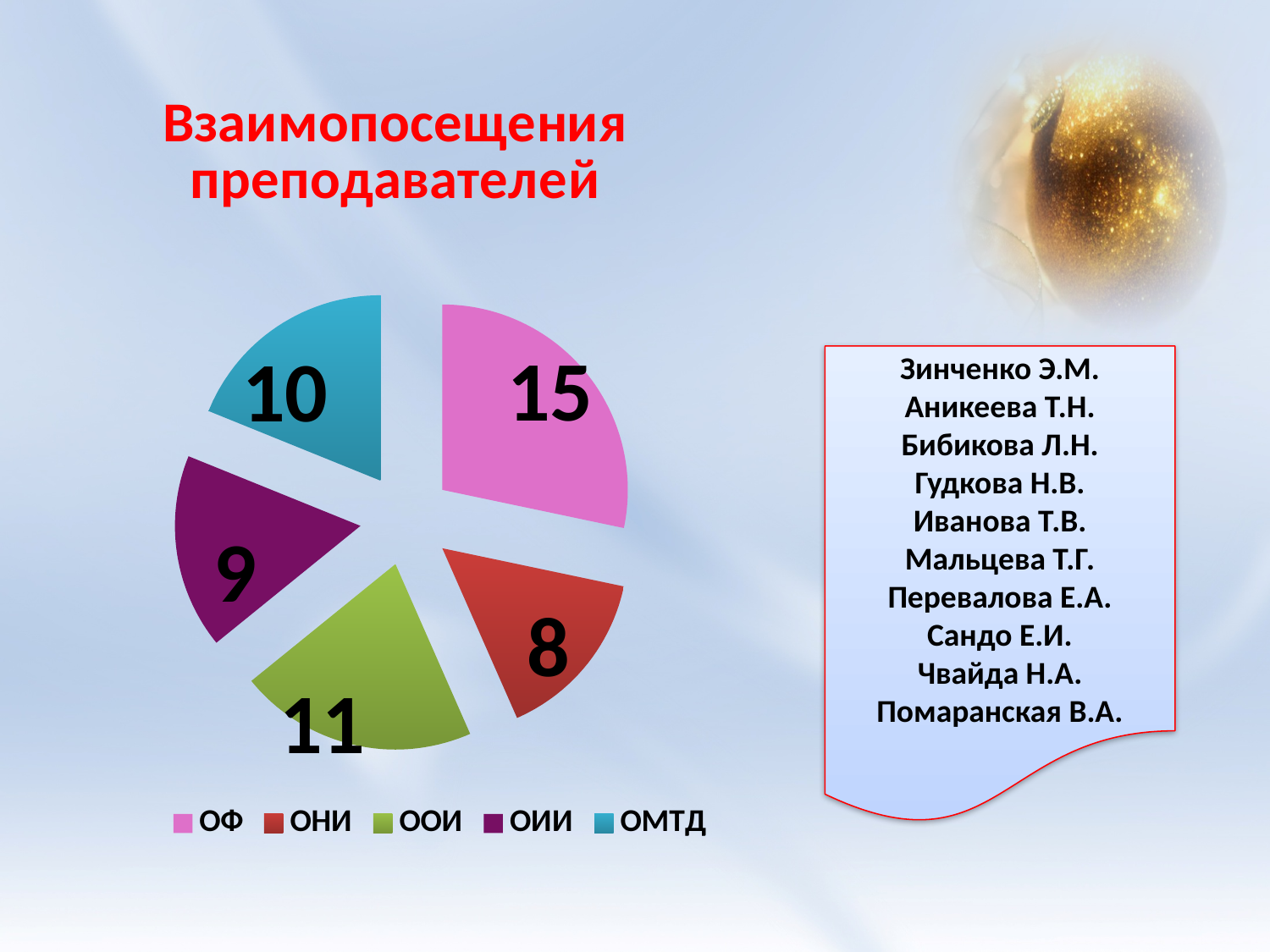
What is the value for ООИ in the pie chart? 11 What is the total of all slices in the pie chart? 53 What is the value for ОФ in the pie chart? 15 How many categories does the pie chart have? 5 What is the value for ОМТД in the pie chart? 10 What is the title of the chart on the slide? Взаимопосещения преподавателей Which category has the smallest slice in the pie chart? ОНИ What type of chart is shown on the slide? pie chart Which category has the largest slice in the pie chart? ОФ Which is larger, the value for ООИ or the value for ОИИ? ООИ What is the value for ОНИ in the pie chart? 8 What is the difference between the values for ОФ and ОНИ? 7